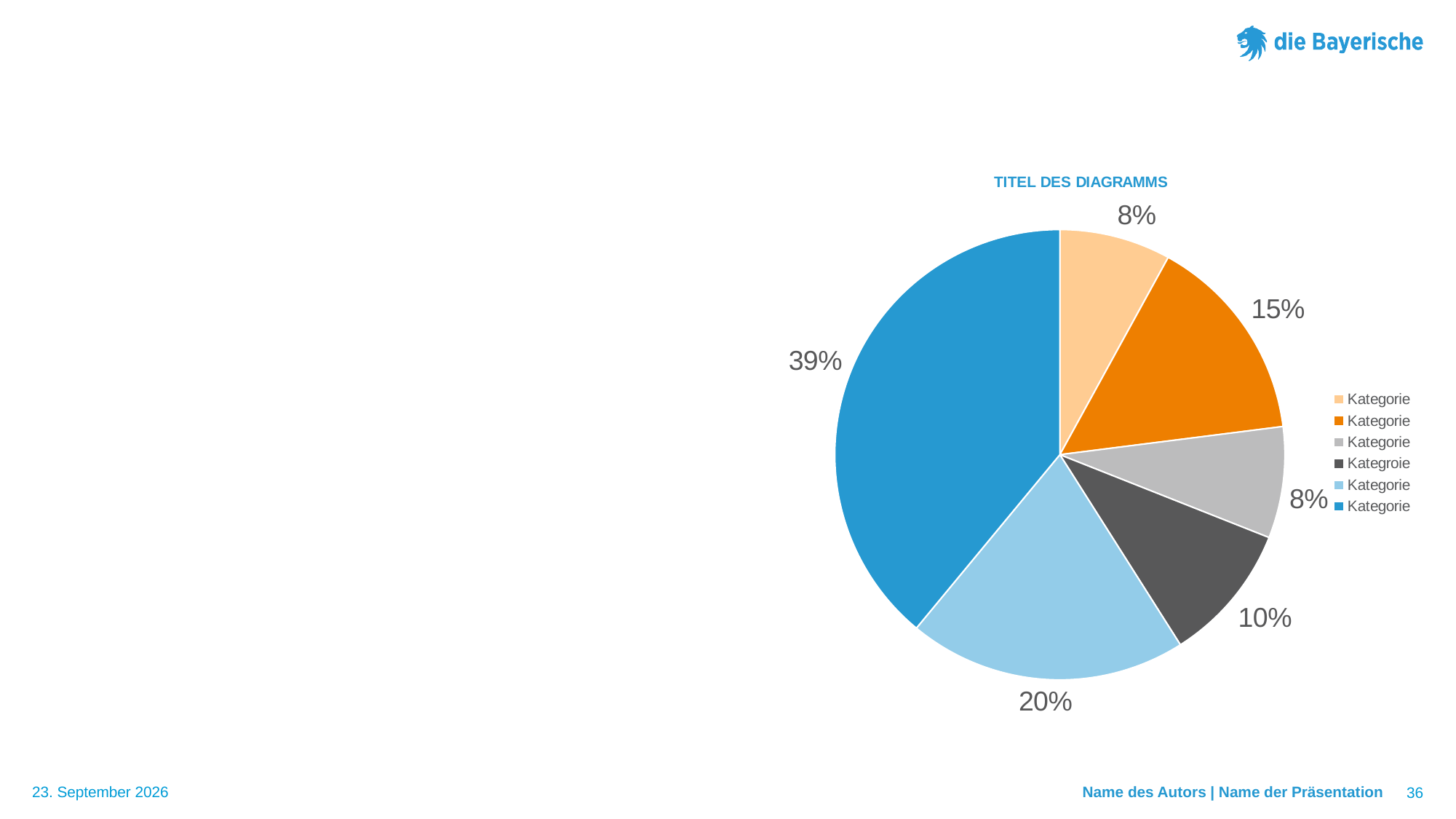
What is the value of the smallest slice of the pie chart? 8% What is the difference between the largest slice (39%) and the light blue slice (20%)? 19 percentage points Which colour is the largest slice of the pie chart? dark blue What kind of chart is shown on the slide? pie chart What value is shown for the dark grey slice? 10% What value is shown for the dark orange slice? 15% How many entries does the legend list? 6 Which slice is larger, the dark orange slice or the dark grey slice? the dark orange slice What value is shown for the light blue slice? 20% What is the title of the chart? TITEL DES DIAGRAMMS What is the value of the largest slice of the pie chart? 39% How many slices does the pie chart have? 6